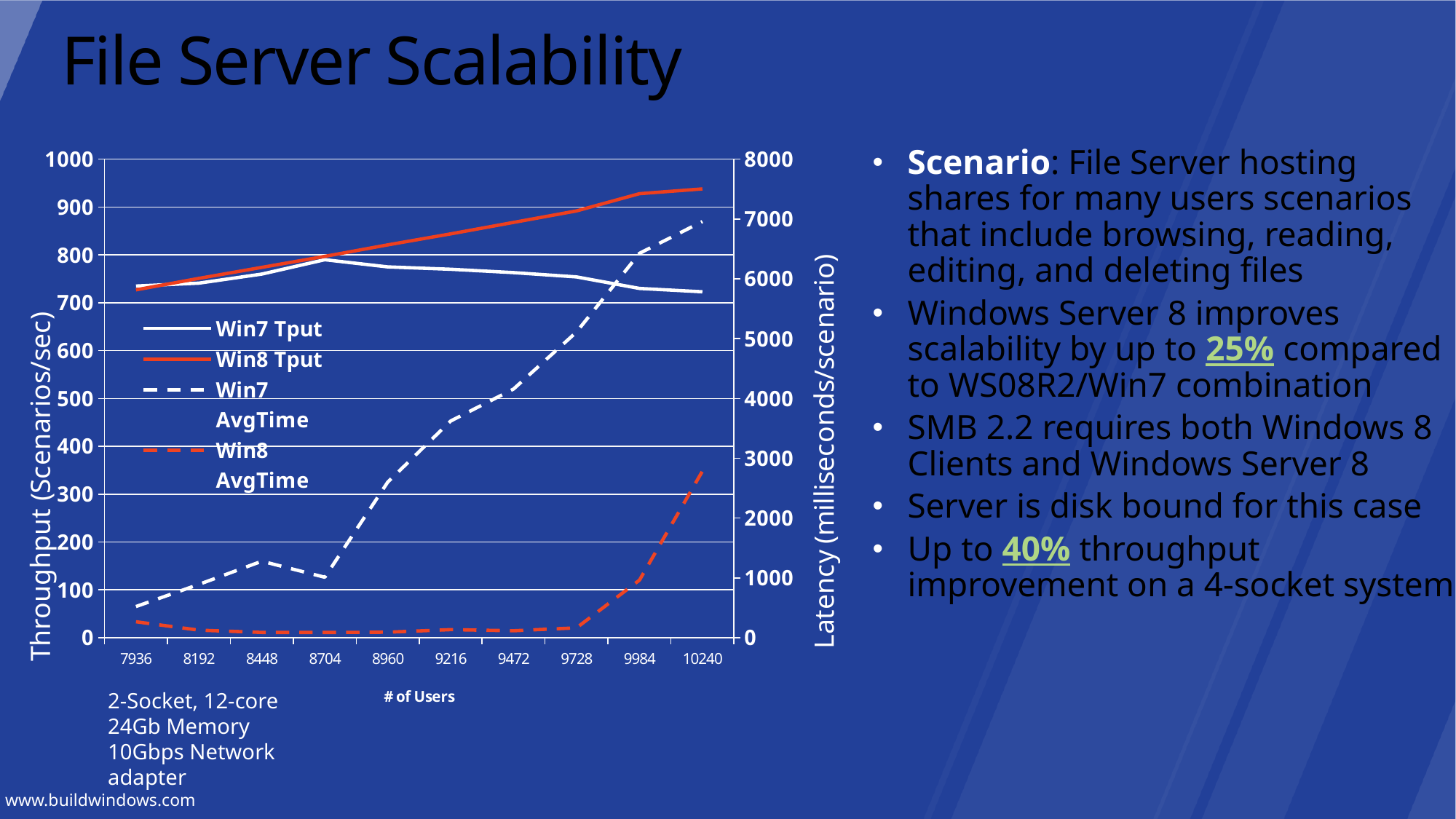
Is the Win8 AvgTime value at 10240 users greater or less than 2000? greater How many series does the chart's legend list? 4 What is the label of the right-hand vertical axis? Latency (milliseconds/scenario) How many # of Users values are plotted along the x axis? 10 At 10240 users, which series has the higher latency, Win7 AvgTime or Win8 AvgTime? Win7 AvgTime Does the Win8 Tput line rise or fall as the number of users increases from 7936 to 10240? rise Is the Win7 AvgTime value at 10240 users greater or less than 6000? greater Is the Win7 Tput value at 10240 users greater or less than 800? less What kind of chart is shown on the slide? line chart At 10240 users, which series has the higher throughput, Win7 Tput or Win8 Tput? Win8 Tput